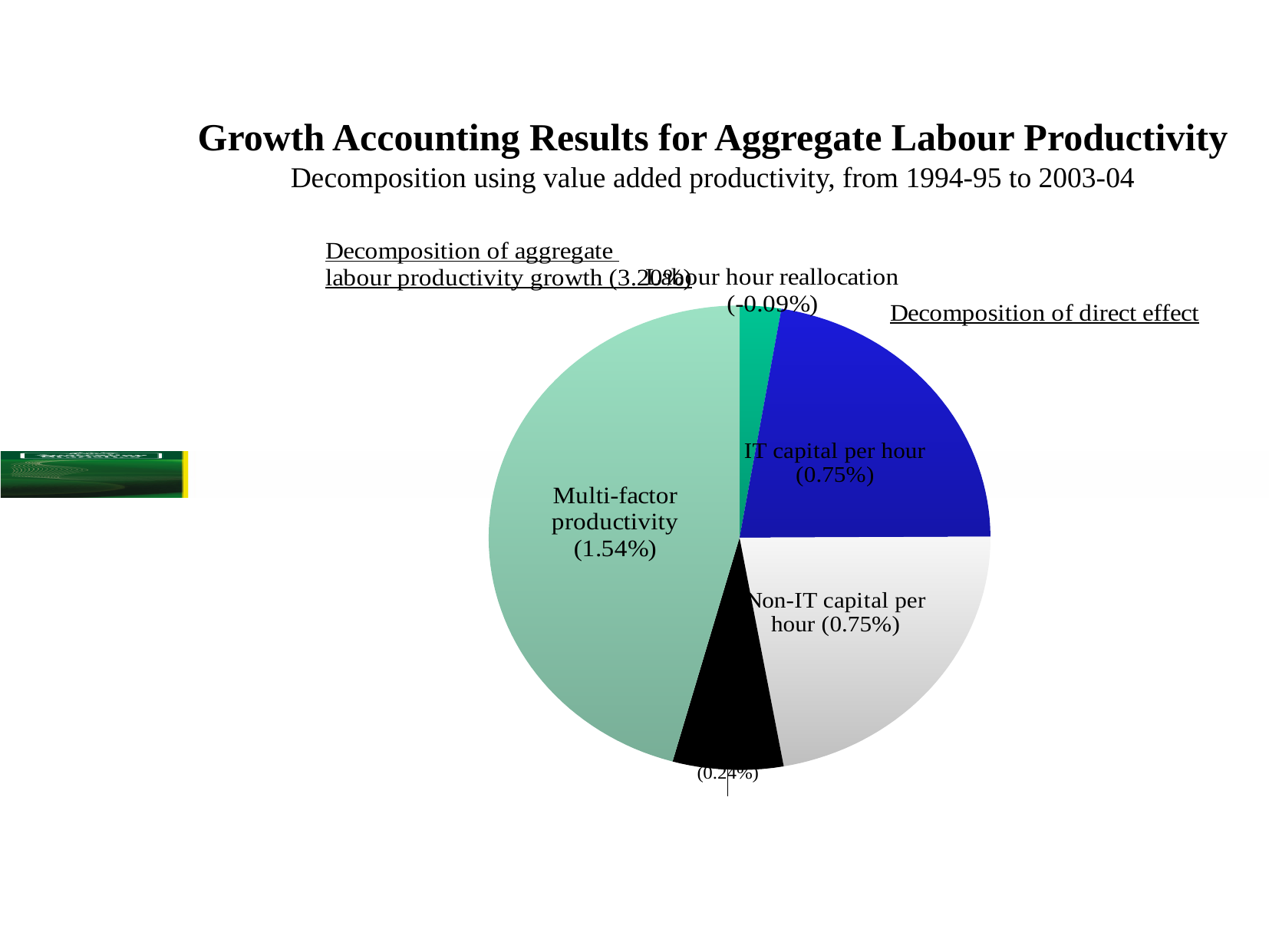
What is the difference between the Multi-factor productivity value and the IT capital per hour value? 0.79% What value is shown for IT capital per hour in the pie chart? 0.75% What value is shown for Multi-factor productivity in the pie chart? 1.54% Which is larger, Multi-factor productivity or Non-IT capital per hour? Multi-factor productivity What kind of chart is shown on the slide? Pie chart Which slice of the pie chart is the largest? Multi-factor productivity What time period does the decomposition cover, according to the subtitle? 1994-95 to 2003-04 How many slices does the pie chart have? 5 What value is shown for Non-IT capital per hour in the pie chart? 0.75% Which slice of the pie chart is the smallest? Labour hour reallocation What value is shown for Labour hour reallocation in the pie chart? -0.09% What is the title of the slide? Growth Accounting Results for Aggregate Labour Productivity